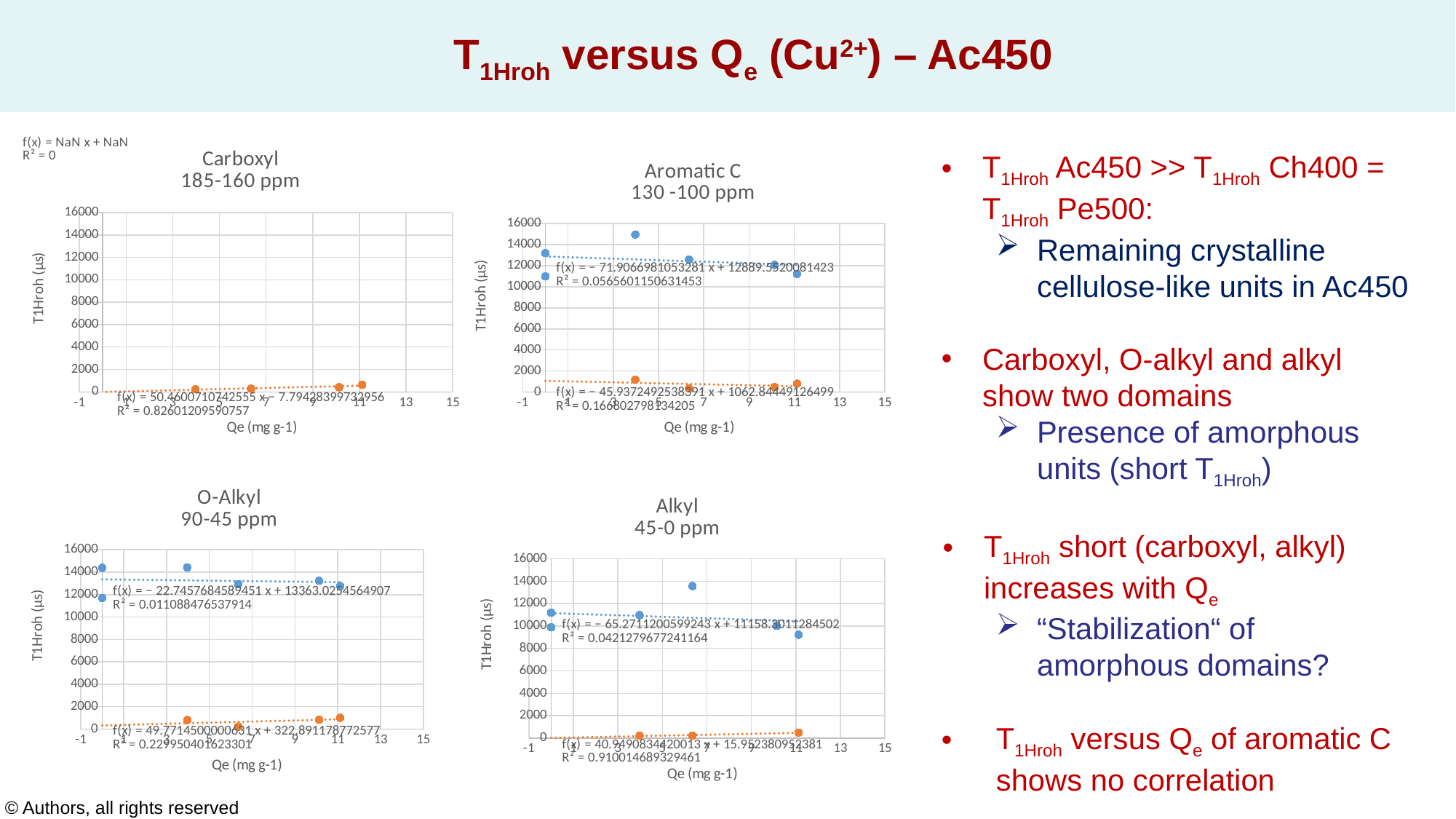
How many charts are shown on the slide? 4 What kind of chart is the 'Carboxyl 185-160 ppm' chart? scatter chart In the 'Carboxyl 185-160 ppm' chart, what is the R² value printed for the orange trendline? 0.82601209590757 What is the y-axis title of the 'O-Alkyl 90-45 ppm' chart? T1Hroh (µs) What is the x-axis title of the 'Alkyl 45-0 ppm' chart? Qe (mg g-1) In the 'O-Alkyl 90-45 ppm' chart, what is the R² value printed for the blue (upper) trendline? 0.011088476537914 In the 'Aromatic C 130 -100 ppm' chart, does the blue trendline rise or fall as Qe increases? fall In the 'O-Alkyl 90-45 ppm' chart, are all the orange points greater or less than 2000? less In the 'Alkyl 45-0 ppm' chart, what is the R² value printed for the orange (lower) trendline? 0.910014689329461 In the 'Aromatic C 130 -100 ppm' chart, is the highest blue point greater or less than 14000? greater In the 'Aromatic C 130 -100 ppm' chart, what is the R² value printed for the blue (upper) trendline? 0.0565601150631453 In the 'Alkyl 45-0 ppm' chart, is the highest blue point greater or less than 12000? greater